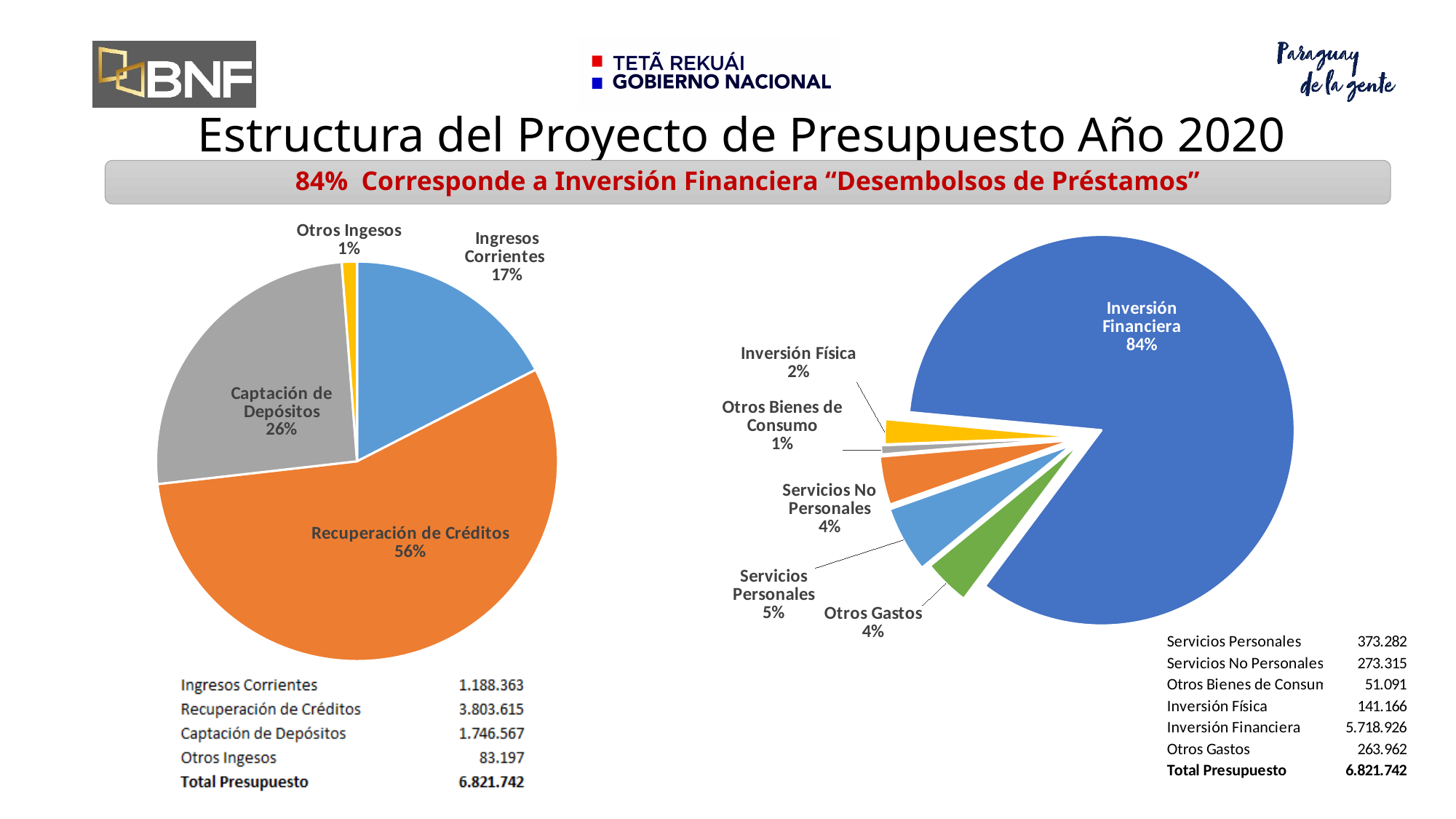
In the right pie chart, which is larger: Servicios Personales or Inversión Física? Servicios Personales How many slices does the right pie chart have? 6 In the left pie chart, what share does Recuperación de Créditos have? 56% How many slices does the left pie chart have? 4 In the left pie chart, which slice is the largest? Recuperación de Créditos In the right pie chart, what share does Inversión Financiera have? 84% In the left pie chart, which slice is the smallest? Otros Ingesos In the right pie chart, which slice is the smallest? Otros Bienes de Consumo In the right pie chart, what share does Servicios Personales have? 5% What type of chart is the left chart on the slide? pie chart In the left pie chart, what is the difference in percentage points between Captación de Depósitos and Ingresos Corrientes? 9